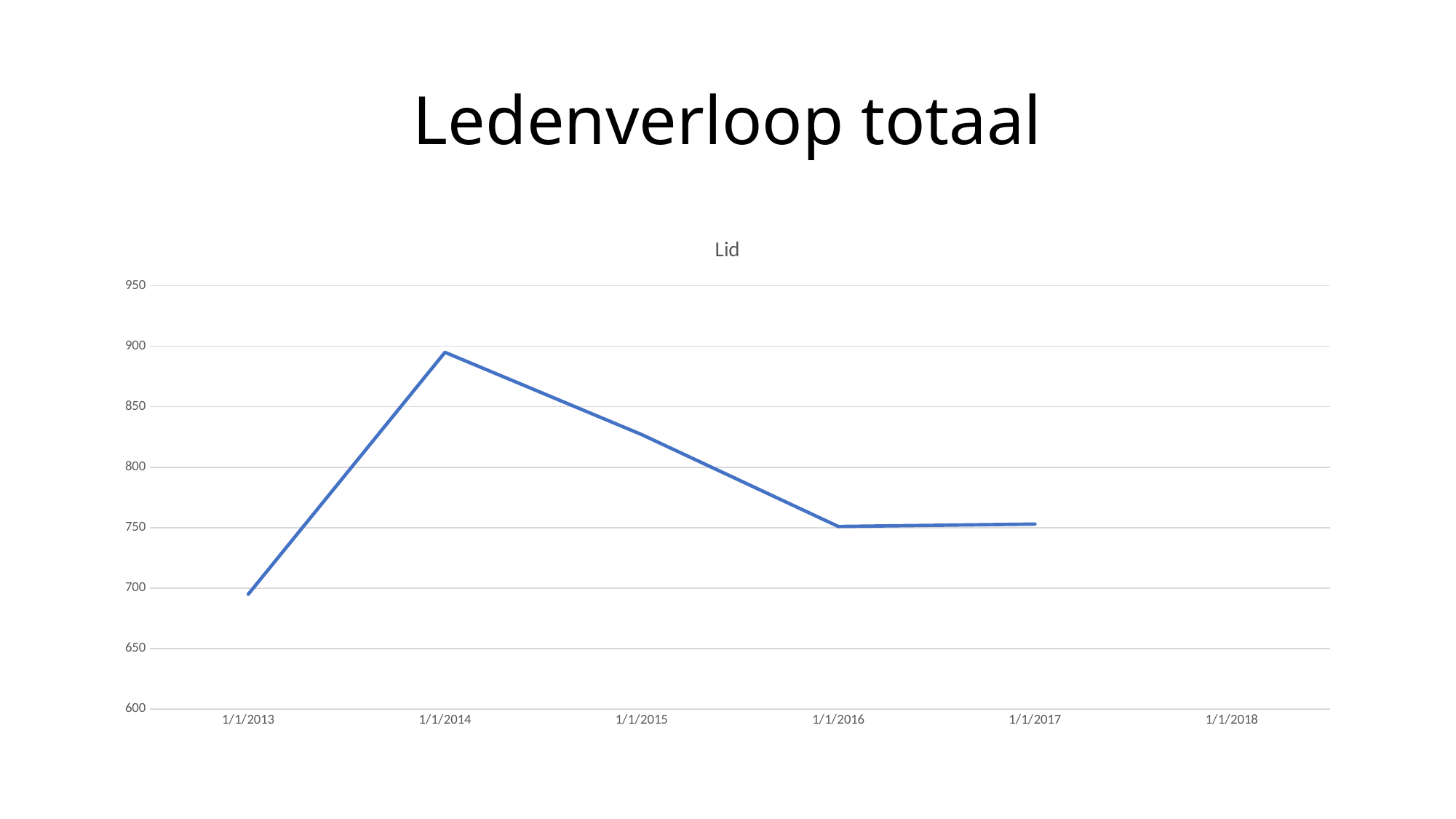
How many date labels are shown on the x axis? 6 Does the line rise or fall between 1/1/2014 and 1/1/2016? fall What kind of chart is shown on the slide? line chart Is the value for 1/1/2013 greater or less than 700? less Is the value for 1/1/2014 greater or less than 850? greater Which is larger, the value for 1/1/2014 or the value for 1/1/2015? 1/1/2014 What is the title of the chart? Lid Is the value for 1/1/2015 greater or less than 800? greater At which date does the line reach its highest value? 1/1/2014 At which date does the line have its lowest value? 1/1/2013